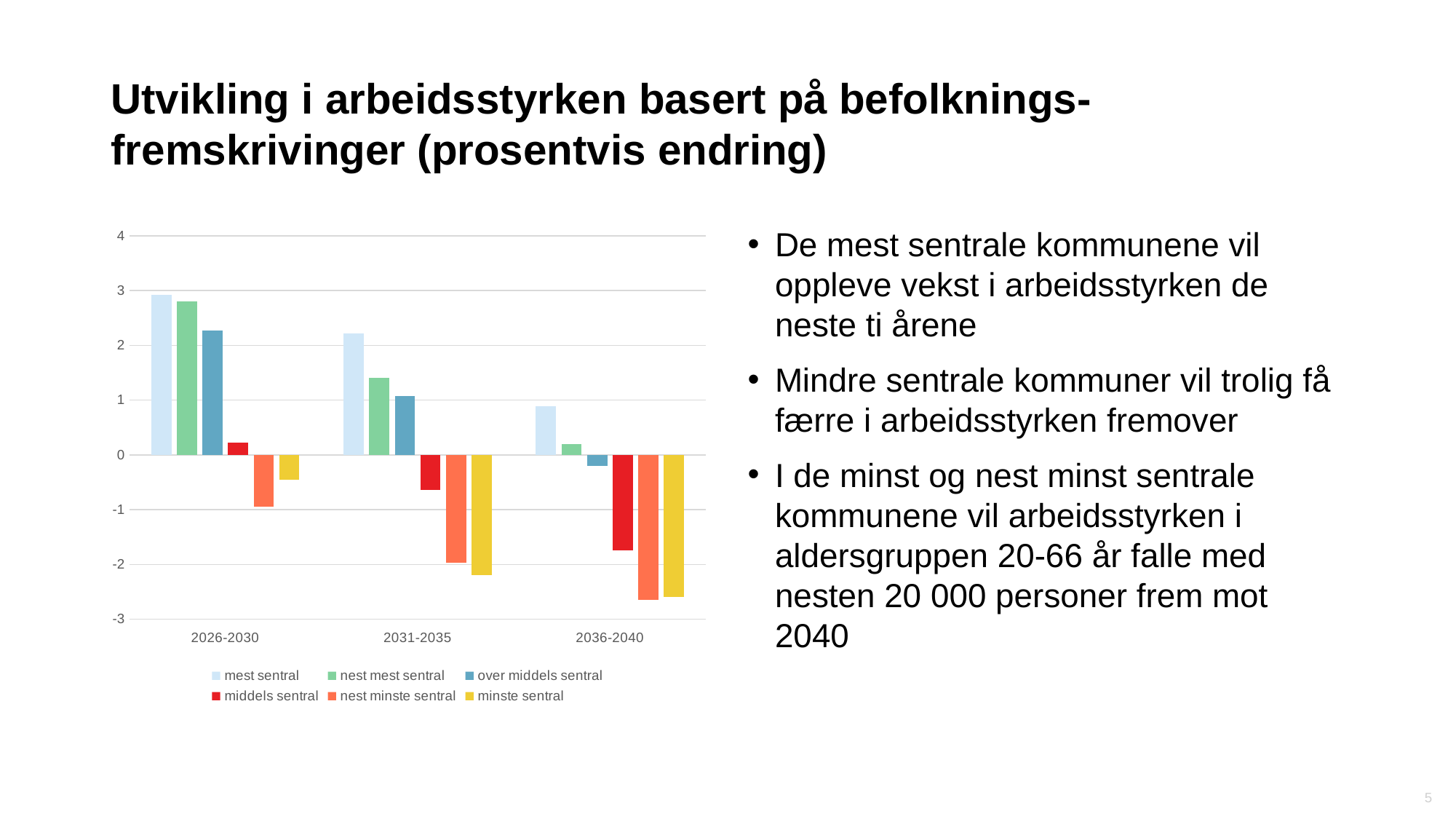
What colour represents 'minste sentral' in the legend? yellow Which series has the highest value in 2031-2035? mest sentral Is the value for 'mest sentral' in 2026-2030 greater or less than 2? greater Does the value for 'mest sentral' rise or fall from 2026-2030 to 2036-2040? fall In 2031-2035, which is larger: 'nest mest sentral' or 'over middels sentral'? nest mest sentral Which series has the lowest value in 2031-2035? minste sentral In 2026-2030, which is larger: 'nest minste sentral' or 'minste sentral'? minste sentral How many time periods are shown on the x axis? 3 What kind of chart is shown on the slide? bar chart Is the value for 'middels sentral' in 2036-2040 greater or less than -1? less How many series does the legend list? 6 Is the value for 'minste sentral' in 2031-2035 greater or less than -1? less